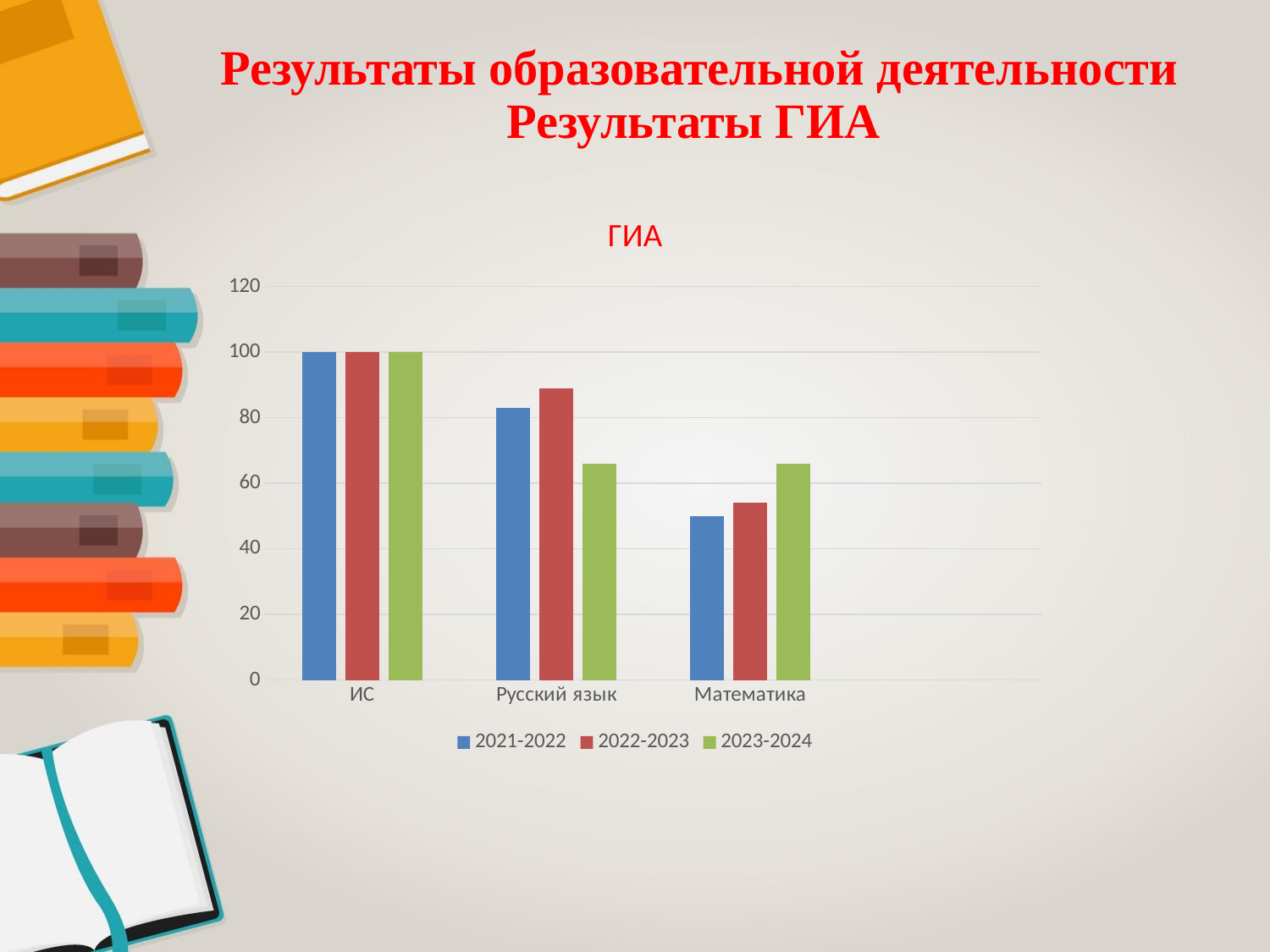
Is the value for Русский язык in 2022-2023 greater or less than 80? greater What kind of chart is shown on the slide? bar chart Is the value for Математика in 2023-2024 greater or less than 60? greater Which series has the lowest value for Русский язык? 2023-2024 How many series does the legend list? 3 What is the value for ИС in 2021-2022? 100 Is the value for Математика in 2021-2022 greater or less than 60? less How many categories are shown on the x axis? 3 For Русский язык, which is larger: the value for 2022-2023 or the value for 2023-2024? 2022-2023 What is the title of the chart? ГИА Which series has the highest value for Математика? 2023-2024 What is the value for ИС in 2023-2024? 100